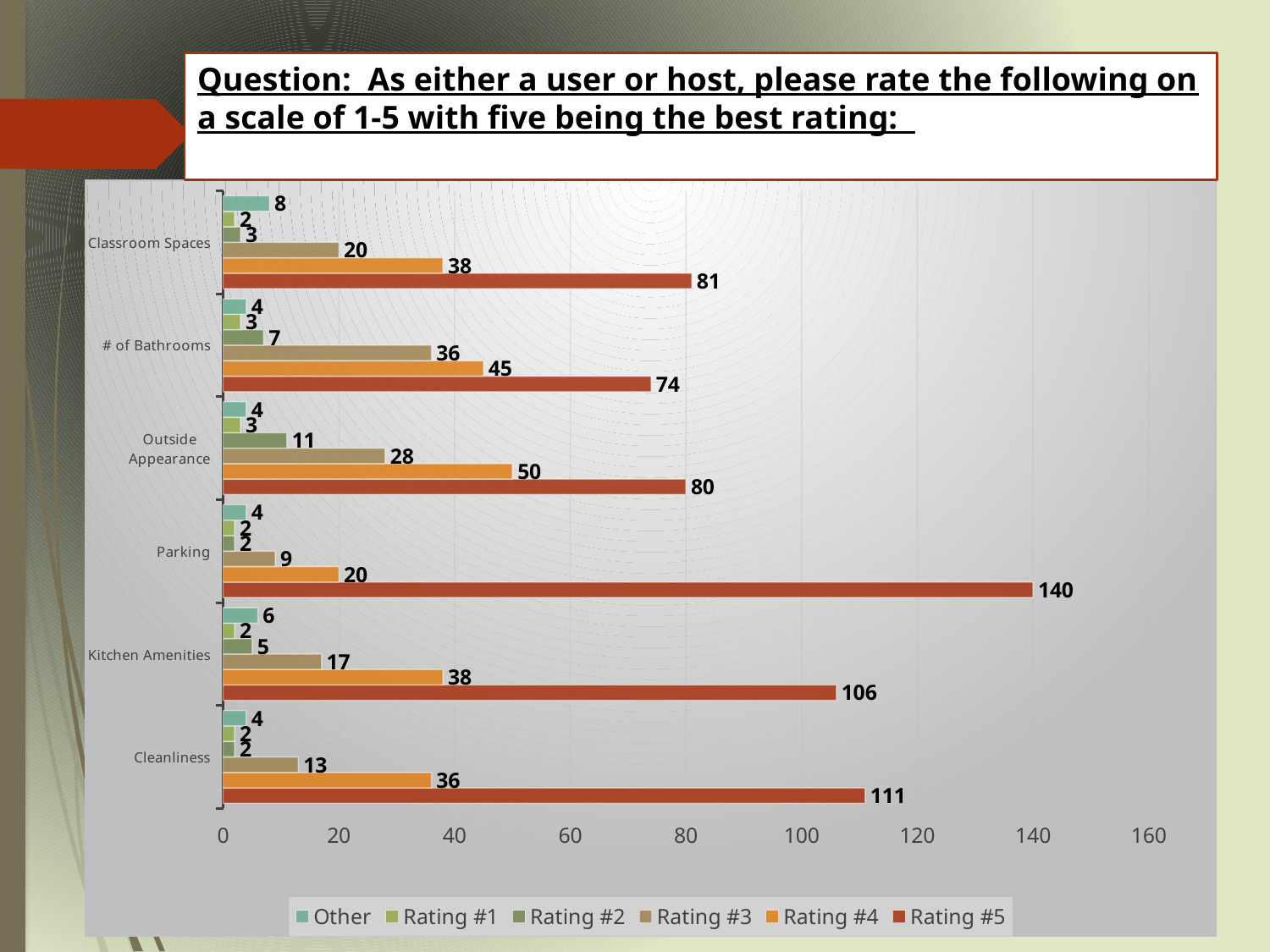
Which category has the highest Rating #5 value? Parking What is the Rating #4 value for Outside Appearance? 50 What is the Other value for Classroom Spaces? 8 How many series does the legend list? 6 How many categories are shown on the chart? 6 Which is larger, the Rating #4 value for # of Bathrooms or the Rating #4 value for Classroom Spaces? # of Bathrooms What is the difference between the Rating #5 values for Cleanliness and Kitchen Amenities? 5 What kind of chart is shown on the slide? Bar chart Is the Rating #5 value for Kitchen Amenities greater or less than 100? greater What is the Rating #3 value for # of Bathrooms? 36 Which category has the lowest Rating #5 value? # of Bathrooms What is the Rating #5 value for Parking? 140